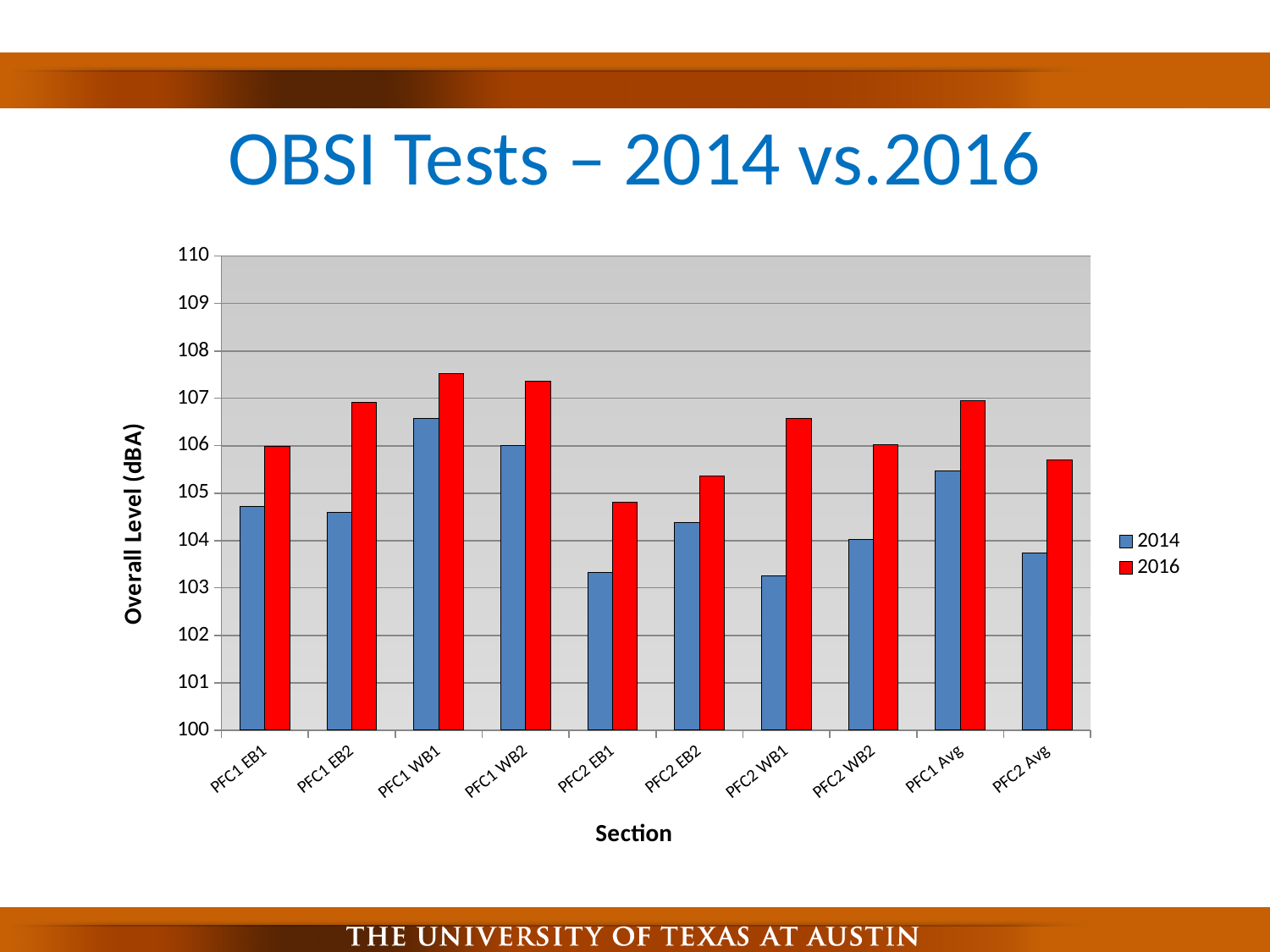
Is the 2016 value for PFC2 Avg greater or less than 106? less Is the 2016 value for PFC1 WB1 greater or less than 107? greater What kind of chart is shown on the slide? Bar chart Is the 2014 value for PFC2 EB1 greater or less than 104? less Which section has the highest 2014 value? PFC1 WB1 For PFC2 WB1, which year has the larger value, 2014 or 2016? 2016 How many series does the legend list? 2 Which is larger for 2014: PFC1 WB1 or PFC1 Avg? PFC1 WB1 Which section has the lowest 2016 value? PFC2 EB1 How many sections are shown along the x axis? 10 What is the title of the vertical axis? Overall Level (dBA)